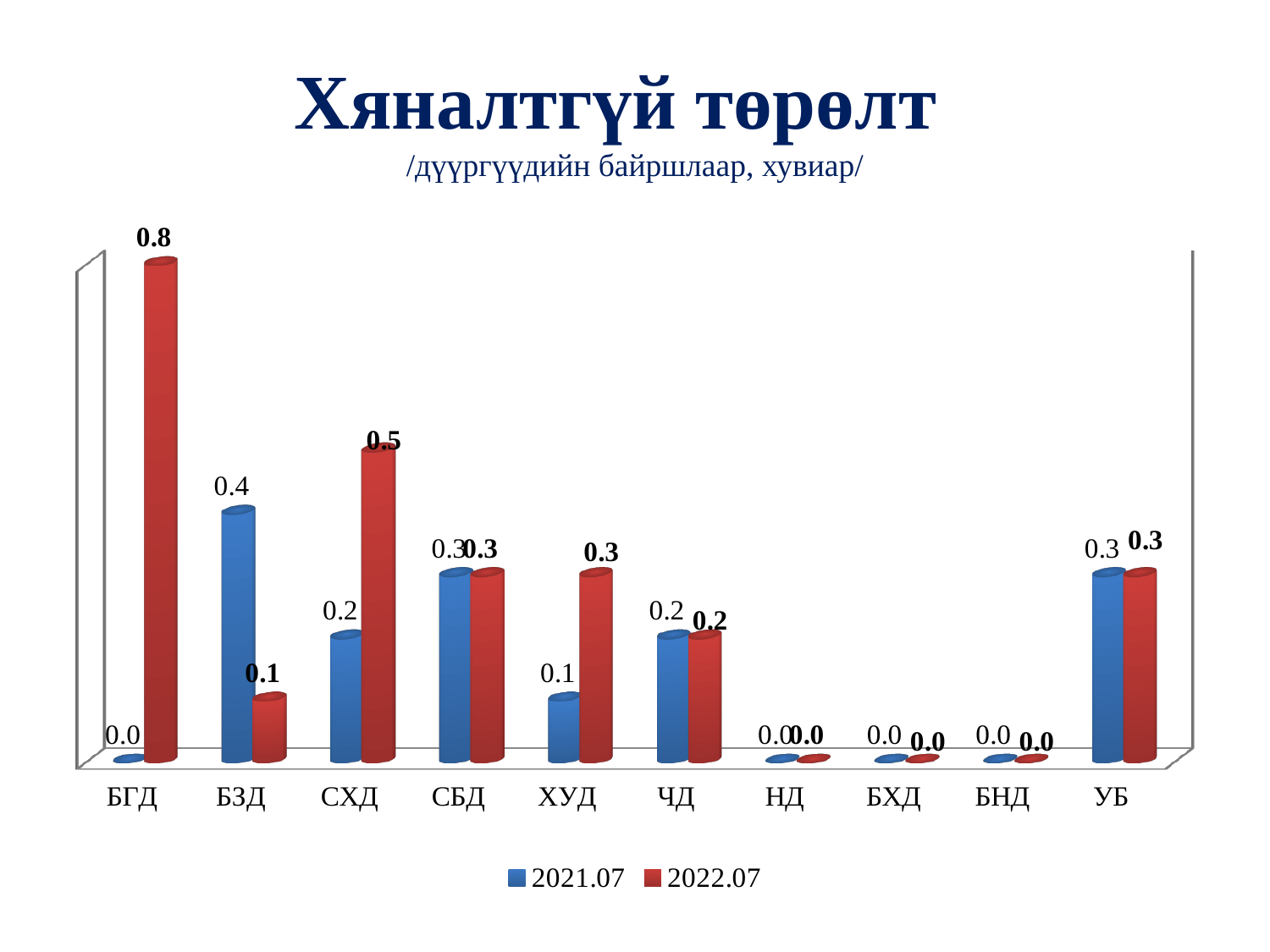
What kind of chart is shown on the slide? Bar chart What is the value for СХД in the 2022.07 series? 0.5 What is the value for БГД in the 2022.07 series? 0.8 Which category has the highest value in the 2022.07 series? БГД What is the difference between the 2022.07 and 2021.07 values for БГД? 0.8 How many categories are shown on the x axis? 10 Which category has the highest value in the 2021.07 series? БЗД For СХД, which series has the larger value, 2021.07 or 2022.07? 2022.07 What is the value for ХУД in the 2021.07 series? 0.1 What is the value for БЗД in the 2021.07 series? 0.4 How many series does the legend list? 2 What is the difference between the 2021.07 and 2022.07 values for БЗД? 0.3